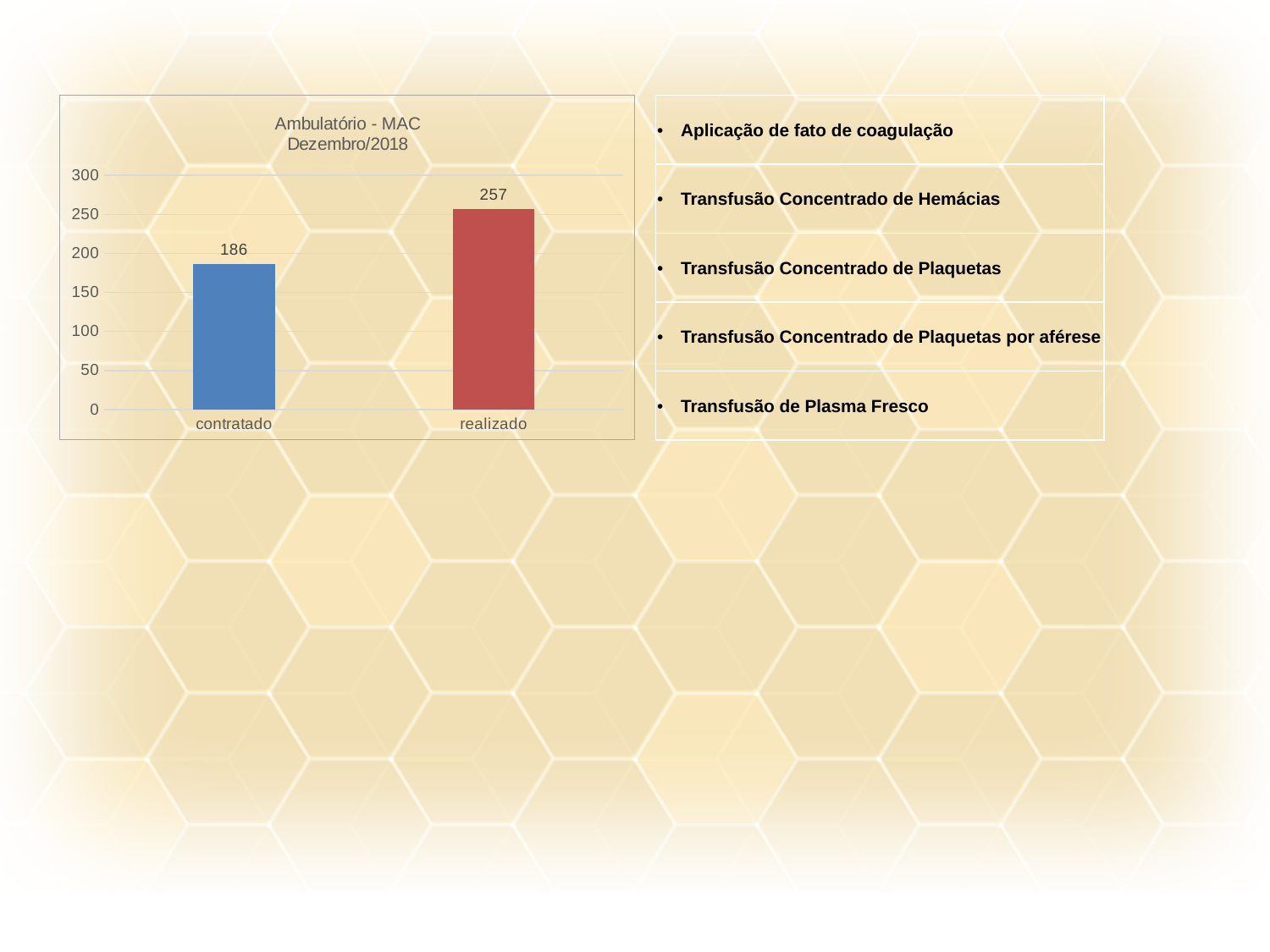
What kind of chart is shown? bar chart What colour is the bar for contratado? blue What is the difference between the realizado and contratado values? 71 Which category has the lowest value? contratado What is the title of the chart? Ambulatório - MAC Dezembro/2018 What is the value for realizado? 257 How many categories are shown in the chart? 2 Is the value for contratado greater or less than 200? less Which is larger, contratado or realizado? realizado Which category has the highest value? realizado Is the value for realizado greater or less than 250? greater What is the value for contratado? 186